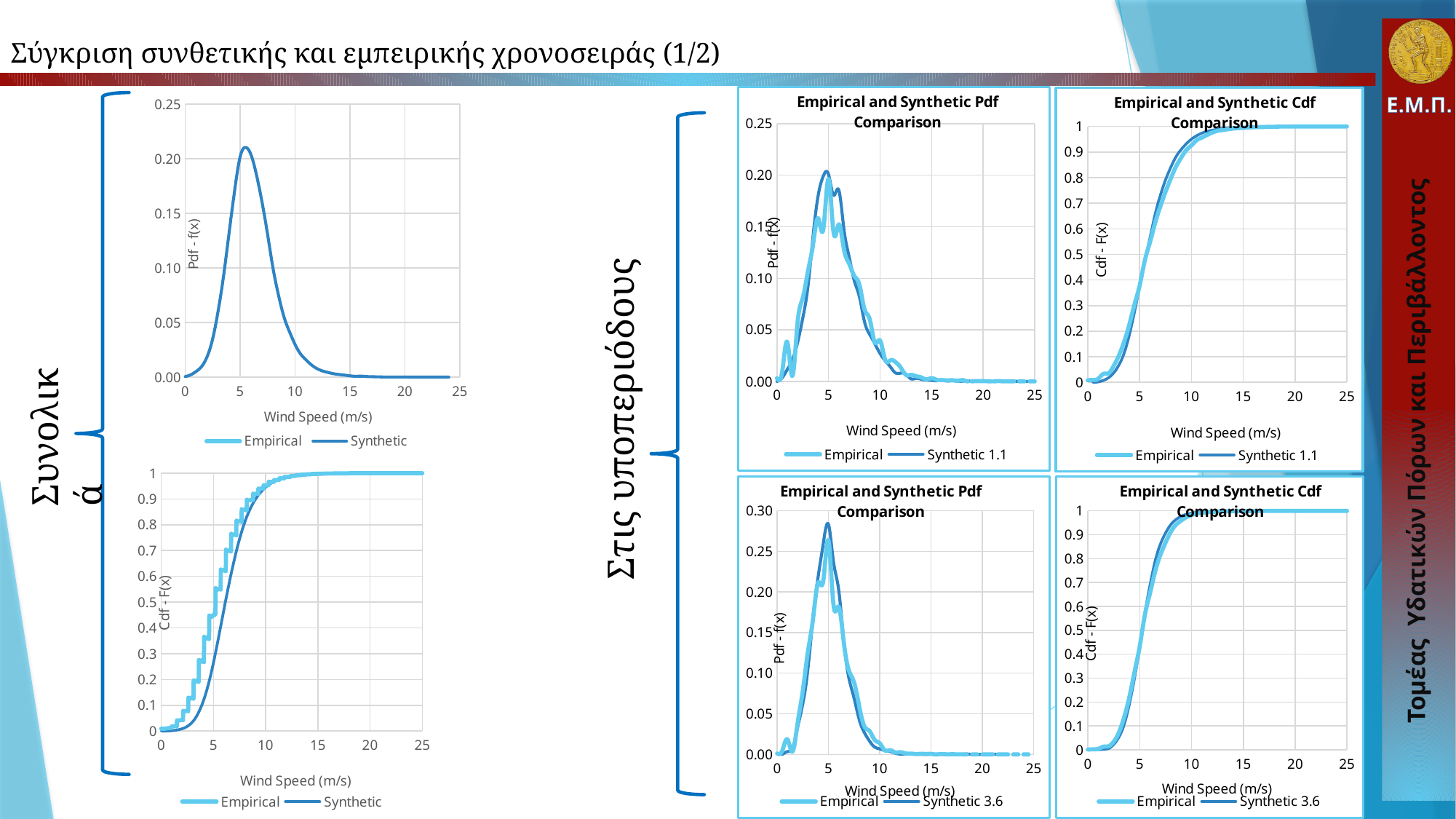
In the top-left Pdf chart, is the peak value of the curve greater or less than 0.15? greater What is the x-axis label of the bottom-left chart? Wind Speed (m/s) In the top-right Cdf chart titled 'Empirical and Synthetic Cdf Comparison', is the value at a wind speed of 5 m/s greater or less than 0.5? less In the bottom-right Pdf chart titled 'Empirical and Synthetic Pdf Comparison', is the peak value of the curves greater or less than 0.25? greater What are the two legend entries of the bottom-left chart? Empirical and Synthetic How many series does the legend of the top-left chart list? 2 In the bottom-left Cdf chart, do the values rise or fall as wind speed increases along the x axis? rise In the top-right Pdf chart titled 'Empirical and Synthetic Pdf Comparison', what is the name of the synthetic series in the legend? Synthetic 1.1 How many charts are shown on the slide in total? 6 How many series does the legend of the bottom-right Cdf chart list? 2 What kind of chart is the top-left chart on the slide? line chart